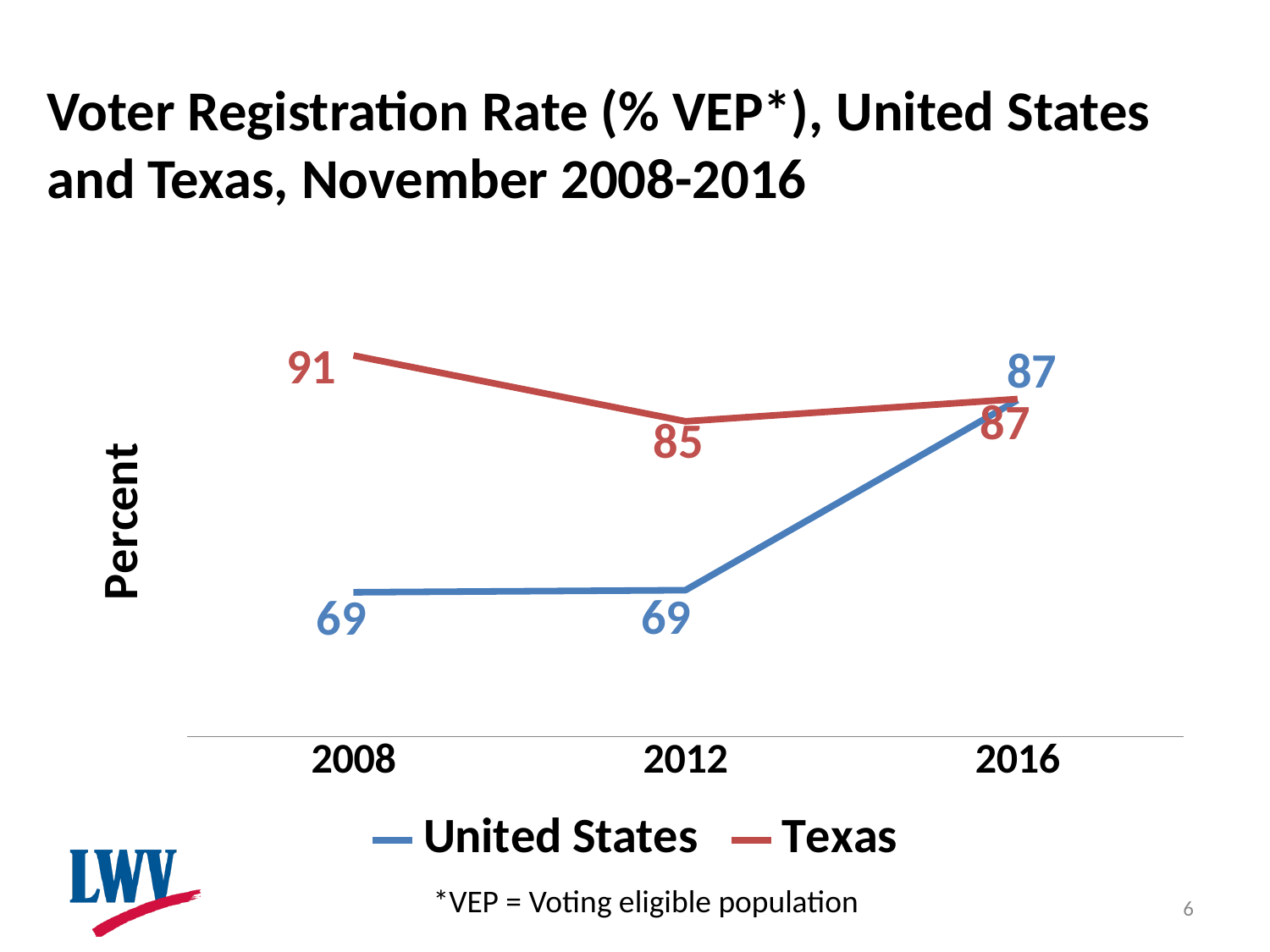
What is the difference between the Texas and United States voter registration rates in 2008? 22 What is the voter registration rate for the United States in 2012? 69 What kind of chart is shown on the slide? Line chart Does the United States voter registration rate rise or fall from 2012 to 2016? Rise How many series does the legend list? 2 What is the voter registration rate for Texas in 2012? 85 How many years are shown on the x axis? 3 In which year is the Texas voter registration rate highest? 2008 What is the voter registration rate for the United States in 2016? 87 What is the voter registration rate for Texas in 2008? 91 Which had the higher voter registration rate in 2012, the United States or Texas? Texas In which year is the Texas voter registration rate lowest? 2012